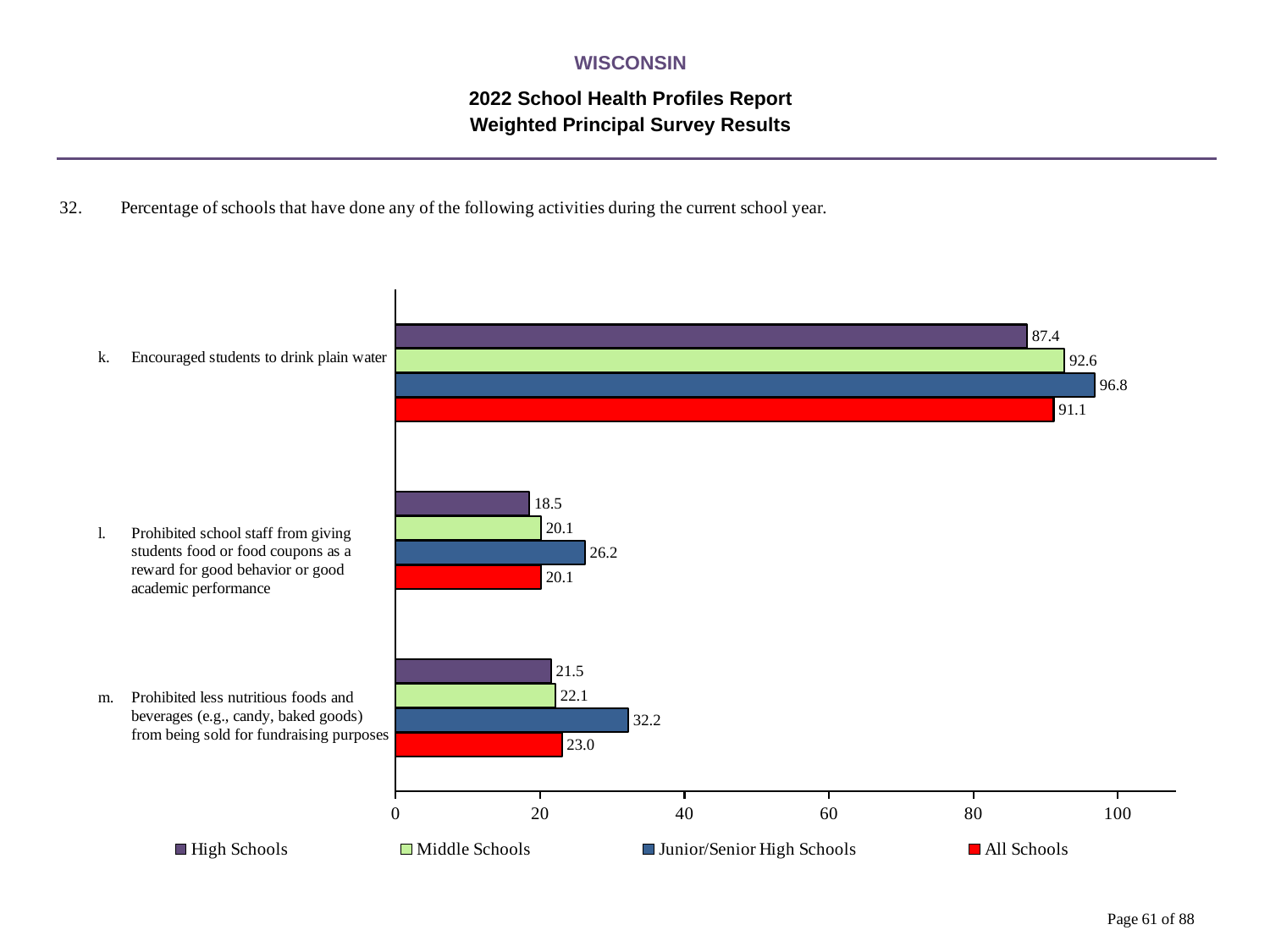
Is the value for All Schools for 'Encouraged students to drink plain water' greater or less than 80? greater Which school type has the highest value for 'Encouraged students to drink plain water'? Junior/Senior High Schools What is the value for All Schools for 'Prohibited less nutritious foods and beverages (e.g., candy, baked goods) from being sold for fundraising purposes'? 23.0 What is the difference between the Junior/Senior High Schools and Middle Schools values for 'Prohibited less nutritious foods and beverages from being sold for fundraising purposes'? 10.1 What kind of chart is shown on the slide? Bar chart Which school type has the lowest value for 'Prohibited school staff from giving students food or food coupons as a reward for good behavior or good academic performance'? High Schools How many activity categories are shown on the chart? 3 What is the difference between the Junior/Senior High Schools and High Schools values for 'Encouraged students to drink plain water'? 9.4 What is the value for Junior/Senior High Schools for 'Encouraged students to drink plain water'? 96.8 Which is larger for Middle Schools: the value for 'Encouraged students to drink plain water' or the value for 'Prohibited less nutritious foods and beverages from being sold for fundraising purposes'? Encouraged students to drink plain water How many series does the legend list? 4 What is the value for High Schools for 'Prohibited school staff from giving students food or food coupons as a reward for good behavior or good academic performance'? 18.5